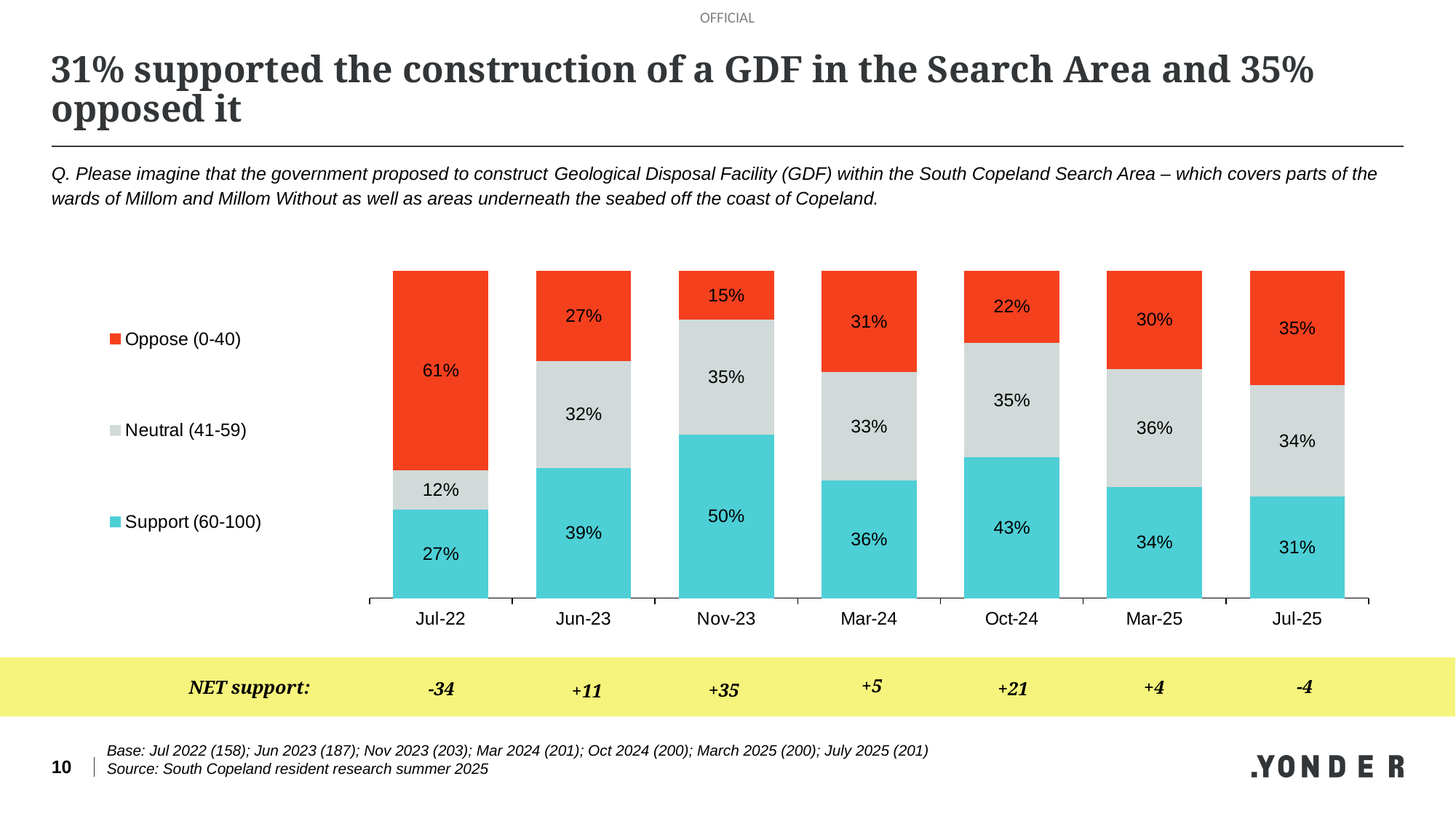
What is the difference between the Support (60-100) share in Nov-23 and in Jul-22? 23 percentage points What was the Neutral (41-59) share in Nov-23? 35% Which is larger in Mar-24: the Support (60-100) share or the Oppose (0-40) share? Support (60-100) How many series does the legend list? 3 How many survey waves are shown on the x axis? 7 What percentage of respondents opposed (0-40) a GDF in Jul-22? 61% What percentage of respondents supported (60-100) a GDF in Jul-25? 31% In which survey wave was Oppose (0-40) lowest? Nov-23 In which survey wave was Support (60-100) highest? Nov-23 Which colour represents Oppose (0-40) in the chart? Red What kind of chart is shown on the slide? Stacked bar chart What is the NET support figure shown for Oct-24? +21